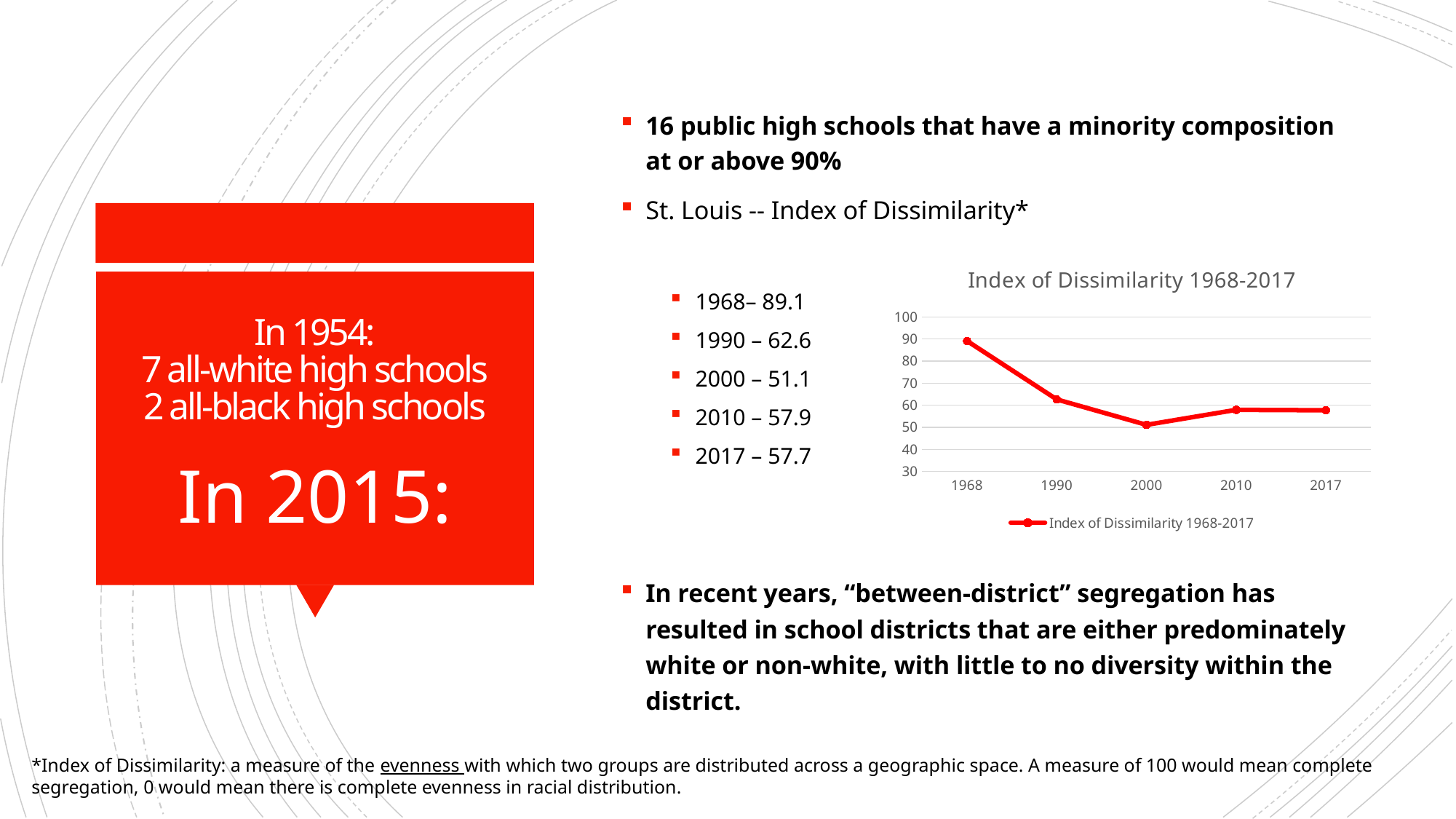
What kind of chart is shown under the title "Index of Dissimilarity 1968-2017"? line chart How many data points are plotted on the Index of Dissimilarity line? 5 What is the Index of Dissimilarity value for 1968? 89.1 Which year has the lowest Index of Dissimilarity on the chart? 2000 Which year has the highest Index of Dissimilarity on the chart? 1968 What is the Index of Dissimilarity value for 2017? 57.7 What is the Index of Dissimilarity value for 2000? 51.1 Does the Index of Dissimilarity rise or fall between 1968 and 2000? fall What is the difference between the Index of Dissimilarity in 1968 and in 2000? 38.0 Is the Index of Dissimilarity value for 1990 greater or less than 60? greater What is the title of the chart on the slide? Index of Dissimilarity 1968-2017 How many series does the chart legend list? 1